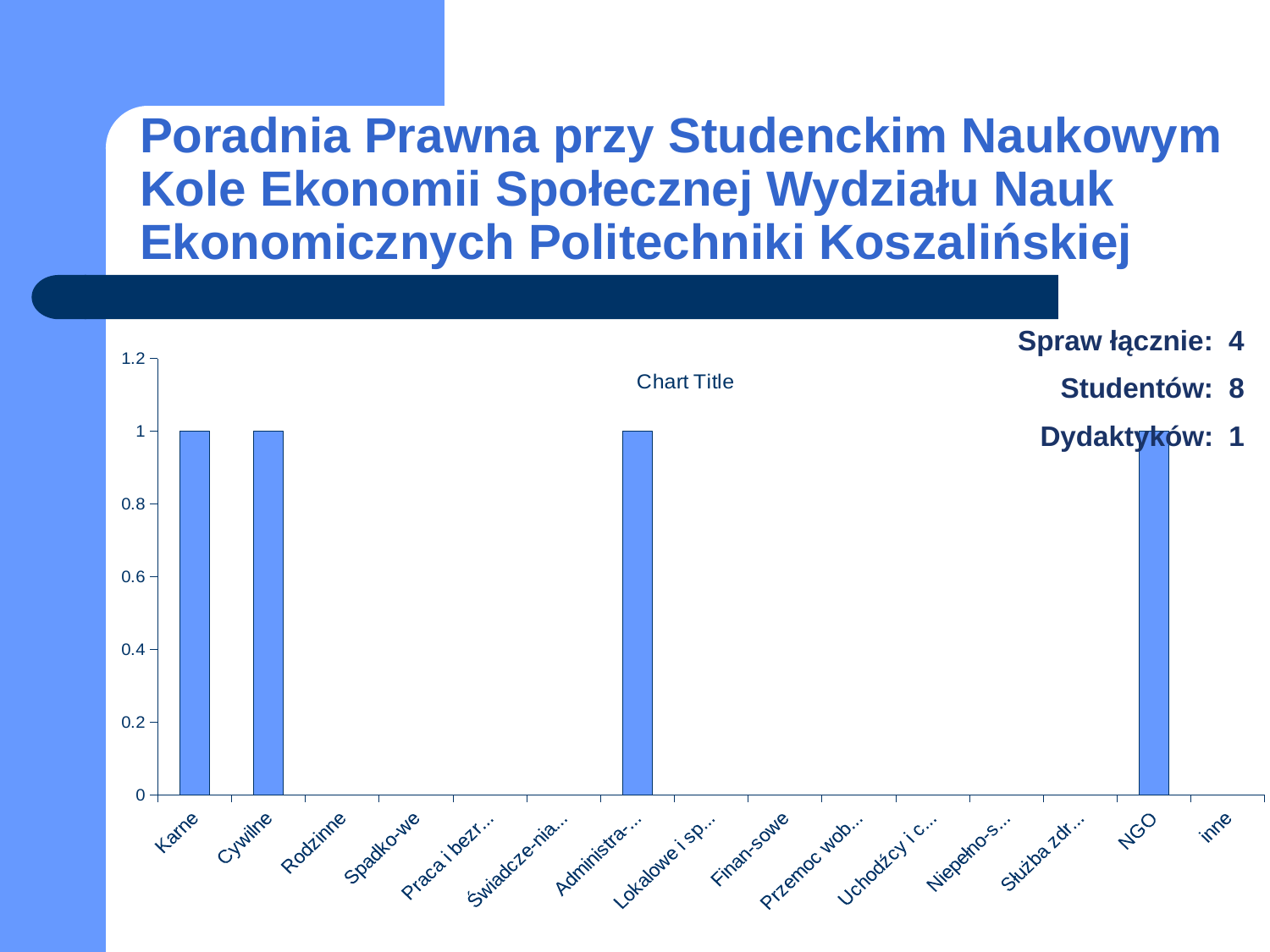
What is the value for Karne? 1 What is the difference between the value for Karne and the value for Spadko-we? 1 How many categories have a visible bar above zero? 4 What is the value for Cywilne? 1 What is the value for NGO? 1 Is the value for Finan-sowe greater or less than 0.2? less Is the value for Karne greater or less than 0.8? greater Which is larger, the value for Cywilne or the value for Rodzinne? Cywilne How many categories are shown on the x axis? 15 What kind of chart is shown on the slide? bar chart What is the title shown on the chart? Chart Title What is the value for Rodzinne? 0